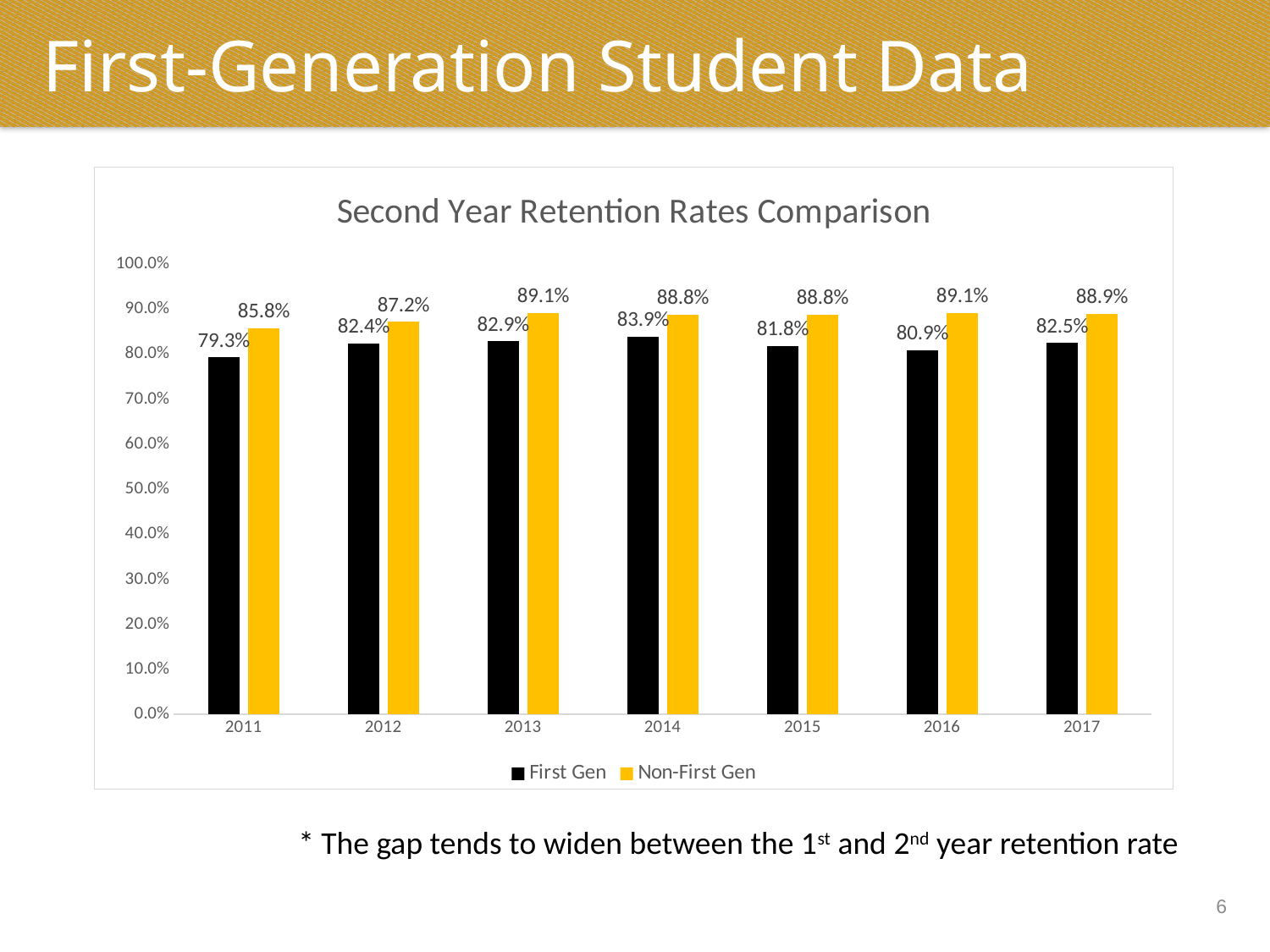
What is the difference between the Non-First Gen and First Gen retention rates in 2011? 6.5% Which year has the lowest Non-First Gen retention rate? 2011 Which year has the lowest First Gen retention rate? 2011 What is the First Gen retention rate for 2016? 80.9% How many years are shown on the x axis? 7 What is the Non-First Gen second year retention rate for 2014? 88.8% Which is larger in 2013, the First Gen or the Non-First Gen retention rate? Non-First Gen What is the difference between the Non-First Gen and First Gen retention rates in 2016? 8.2% How many series does the legend list? 2 What type of chart is shown on the slide? Bar chart Which year has the highest First Gen retention rate? 2014 What is the First Gen second year retention rate for 2011? 79.3%